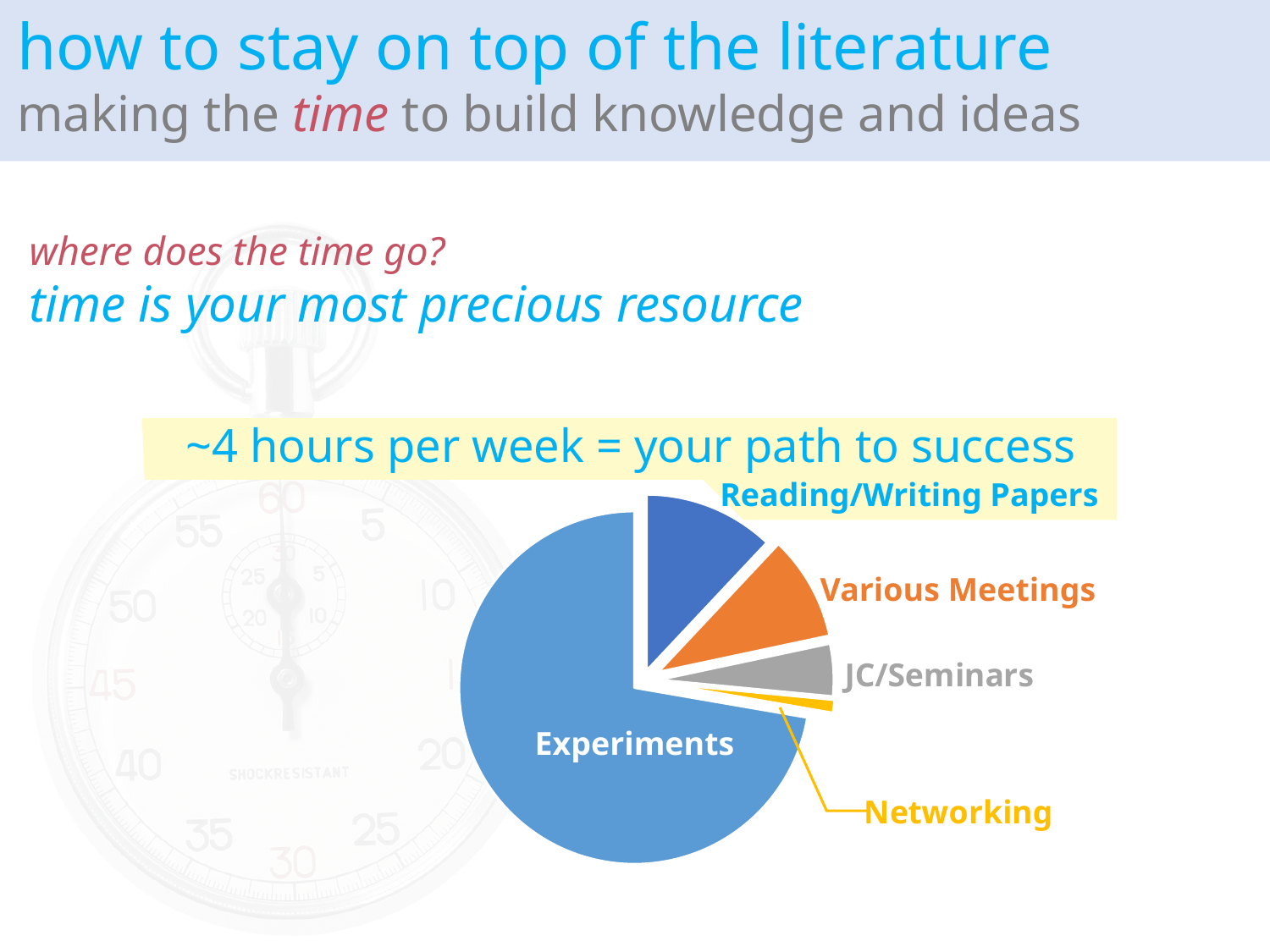
Which category takes up the largest share of the pie chart? Experiments Which category is shown in gray on the pie chart? JC/Seminars What colour is the Various Meetings slice of the pie chart? orange Which slice is larger, Various Meetings or JC/Seminars? Various Meetings Which slice is larger, JC/Seminars or Networking? JC/Seminars Which slice is larger, Various Meetings or Networking? Various Meetings Which category takes up the smallest share of the pie chart? Networking What kind of chart is shown on the slide? pie chart How many slices does the pie chart have? 5